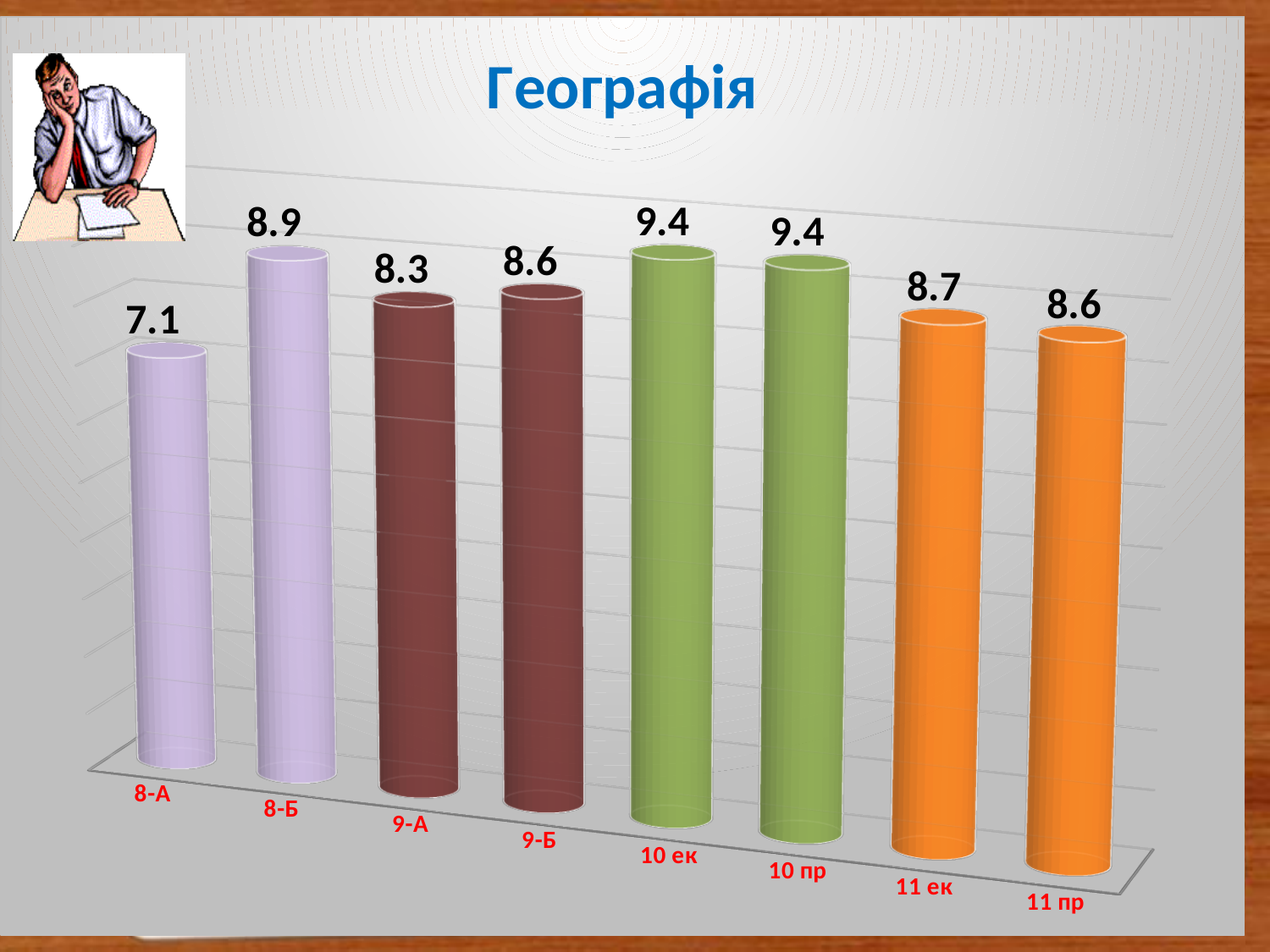
What is the value for 8-Б? 8.9 What is the difference between the values for 10 ек and 11 пр? 0.8 Which category has the lowest value? 8-А What is the value for 11 ек? 8.7 What is the title of the chart? Географія What is the value for 9-А? 8.3 Which is larger, the value for 9-Б or the value for 9-А? 9-Б How many categories are shown in the chart? 8 Which is larger, the value for 11 ек or the value for 11 пр? 11 ек What kind of chart is shown on the slide? Bar chart What is the value for 10 пр? 9.4 What is the difference between the values for 8-Б and 8-А? 1.8